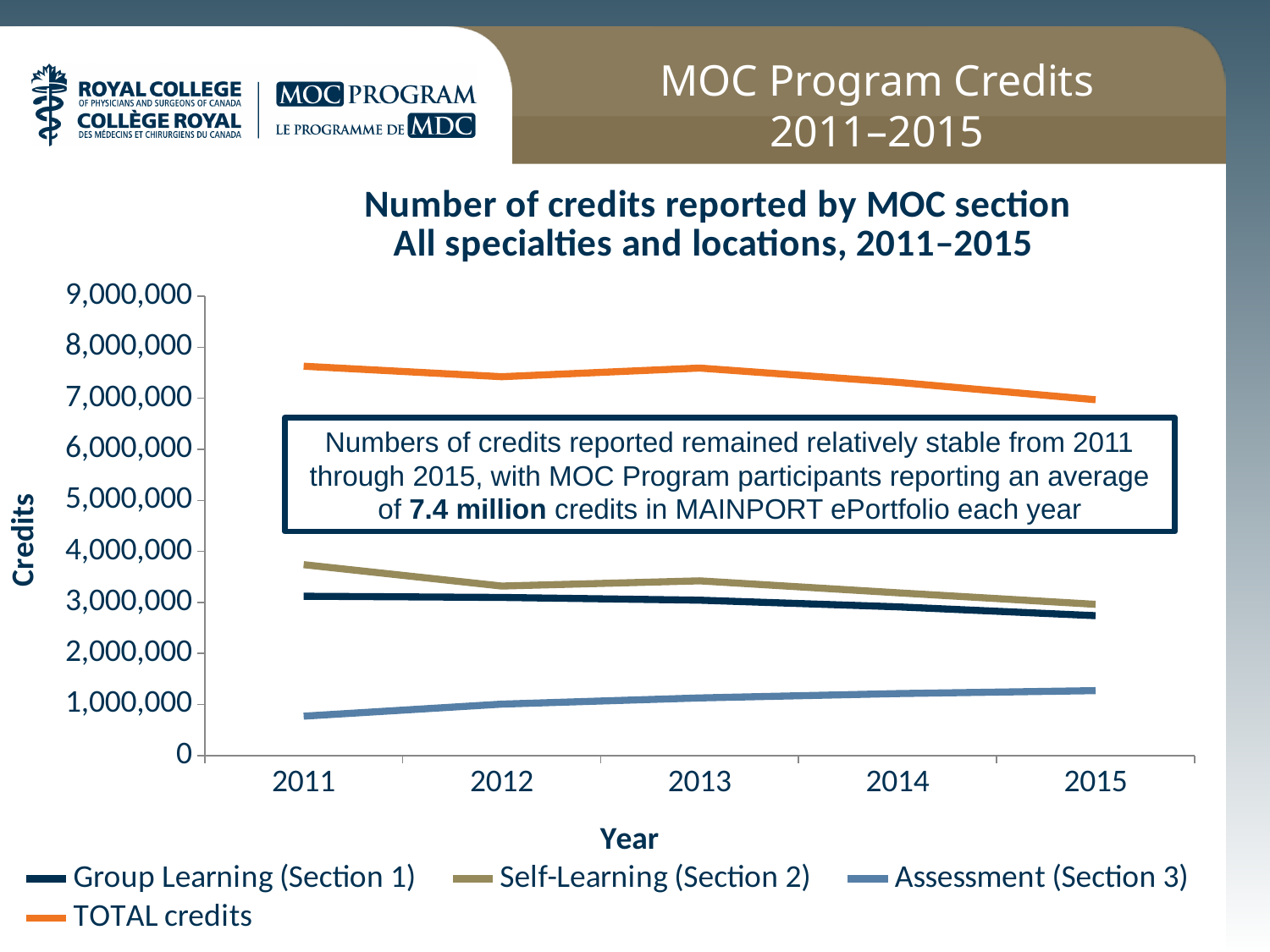
Does the Assessment (Section 3) line rise or fall from 2011 to 2015? Rises Which series has the highest values across all years? TOTAL credits Is the value for Self-Learning (Section 2) in 2011 greater or less than 3,000,000? greater Which series has the lowest values across all years? Assessment (Section 3) Is the value for Assessment (Section 3) in 2011 greater or less than 1,000,000? less How many years are plotted along the x axis? 5 Does the Group Learning (Section 1) line rise or fall from 2011 to 2015? Falls How many series does the legend list? 4 Is the value for TOTAL credits in 2011 greater or less than 7,000,000? greater What kind of chart is shown on the slide? Line chart What is the label on the vertical axis of the chart? Credits In 2011, which is larger: Self-Learning (Section 2) or Group Learning (Section 1)? Self-Learning (Section 2)